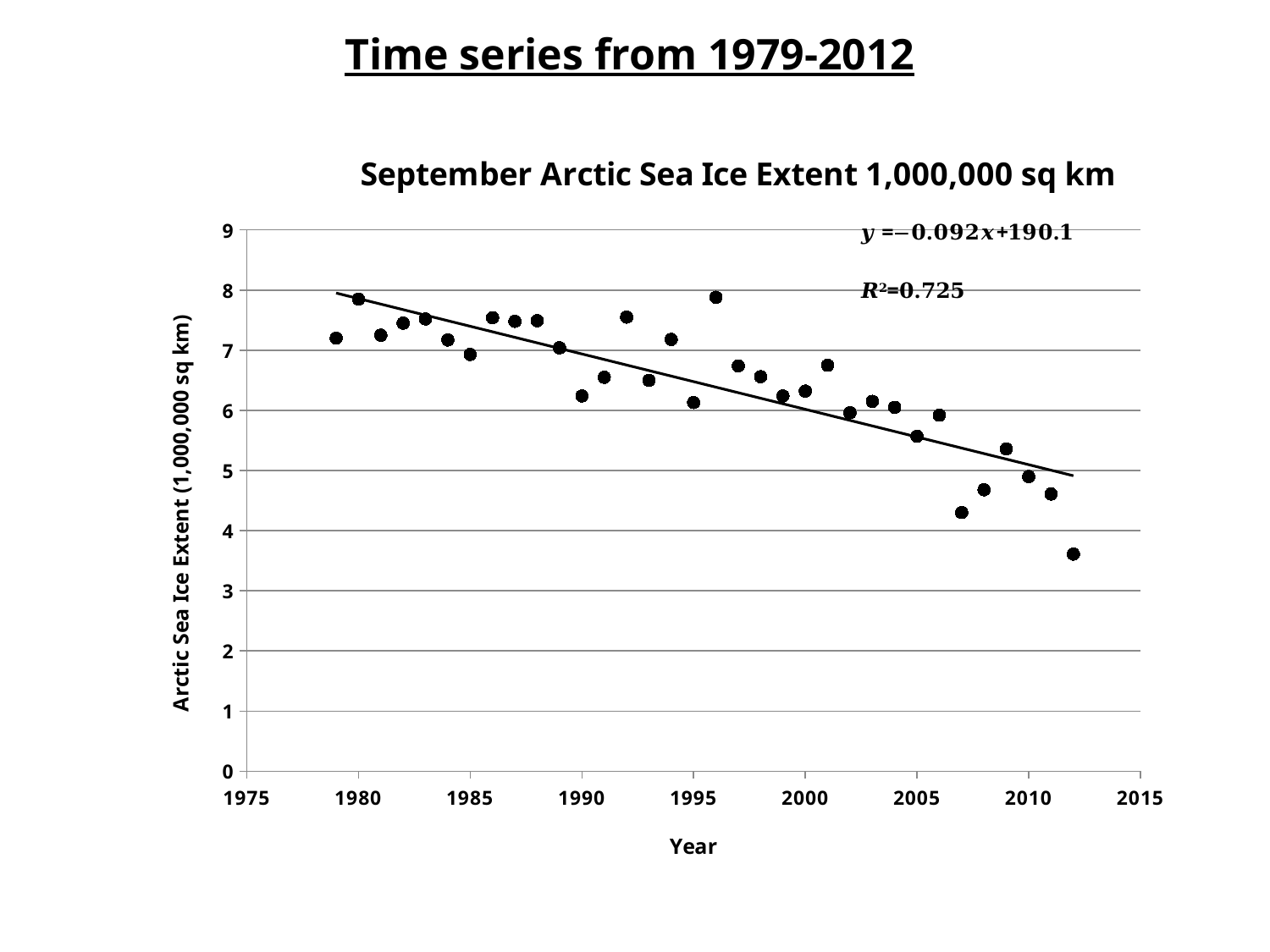
Is the value for 2005 greater or less than 5? greater Is the value for 1980 greater or less than 7? greater Is the value for 2012 greater or less than 4? less What is the R² value shown for the trend line? 0.725 Do the plotted values generally rise or fall as the year increases? Fall Which year has the lowest September Arctic sea ice extent? 2012 Which year has the larger sea ice extent, 2007 or 2009? 2009 What is the label of the x axis? Year Which year has the larger sea ice extent, 1979 or 2012? 1979 What kind of chart is shown on the slide? Scatter plot